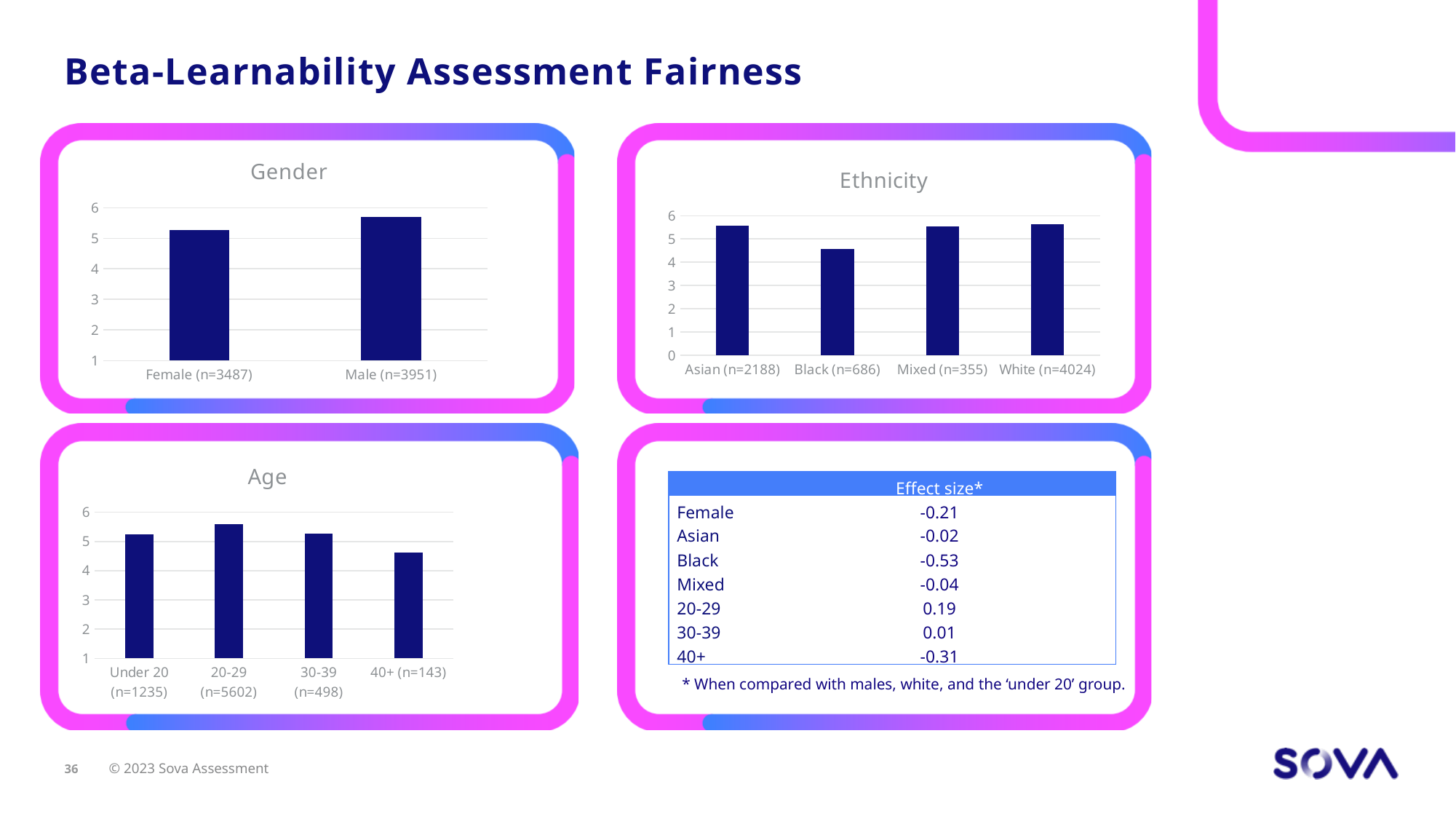
In the Gender chart, which category has the higher value, Female (n=3487) or Male (n=3951)? Male (n=3951) In the Ethnicity chart, is the value for Black (n=686) greater or less than 5? less How many categories are shown in the Ethnicity chart? 4 In the Ethnicity chart, which category has the lowest value? Black (n=686) In the Gender chart, is the value for Female (n=3487) greater or less than 5? greater What is the title of the chart in the bottom-left panel of the slide? Age What kind of chart is the Gender chart? bar chart In the Age chart, is the value for 40+ (n=143) greater or less than 5? less How many categories are shown in the Gender chart? 2 In the Age chart, which category has the lowest value? 40+ (n=143) In the Age chart, which category has the highest value? 20-29 (n=5602)